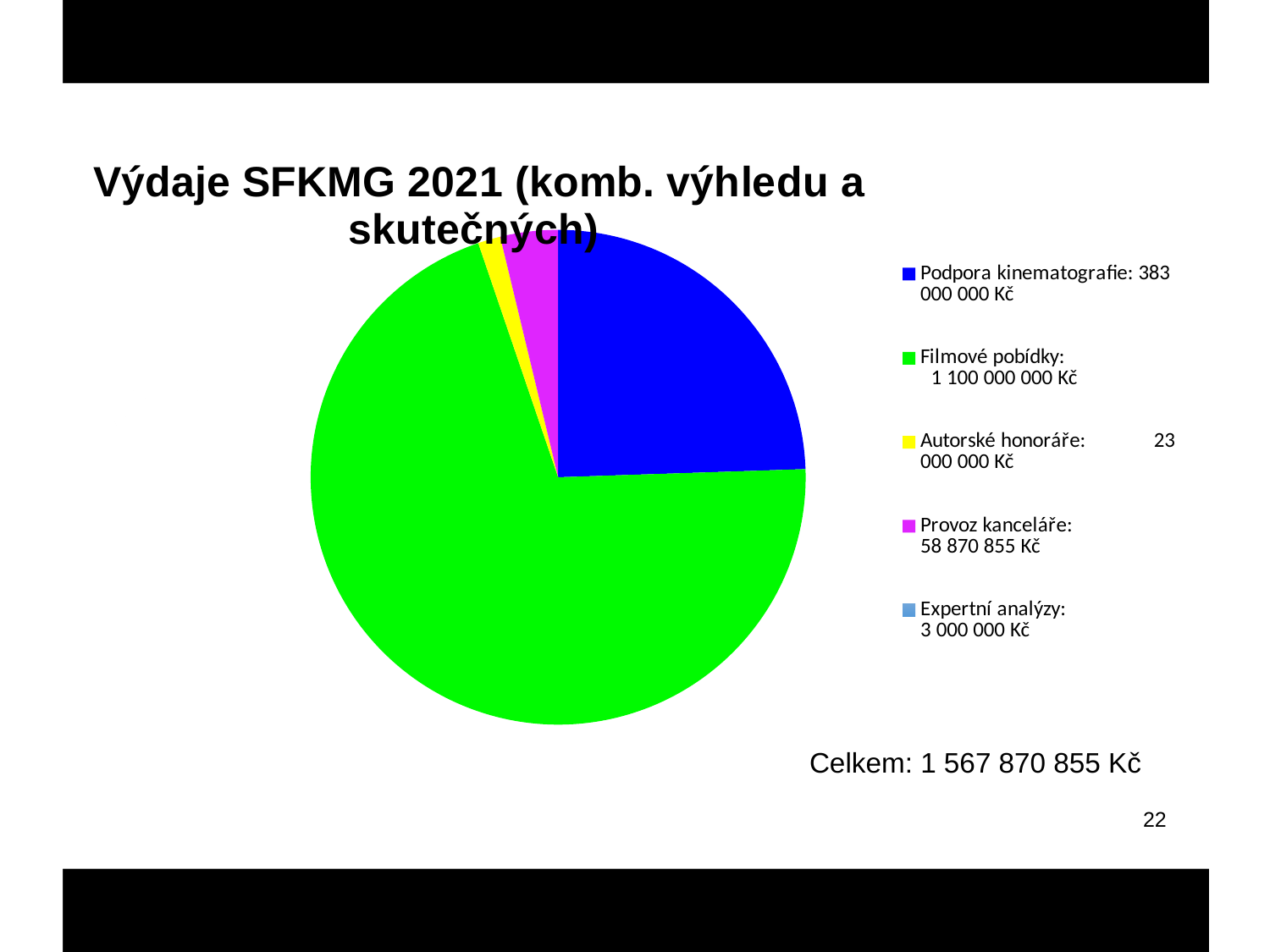
How many categories does the pie chart show? 5 What kind of chart is shown on the slide? Pie chart What is the value for Podpora kinematografie in the pie chart? 383 000 000 Kč What is the total (Celkem) of all expenditures shown on the slide? 1 567 870 855 Kč What is the value for Filmové pobídky in the pie chart? 1 100 000 000 Kč What is the difference between Podpora kinematografie and Autorské honoráře? 360 000 000 Kč What is the value for Expertní analýzy in the pie chart? 3 000 000 Kč What is the value for Provoz kanceláře in the pie chart? 58 870 855 Kč Which is larger, Provoz kanceláře or Autorské honoráře? Provoz kanceláře Which category has the largest slice of the pie chart? Filmové pobídky Which category has the smallest value in the pie chart? Expertní analýzy What colour is the Filmové pobídky slice in the pie chart? Green